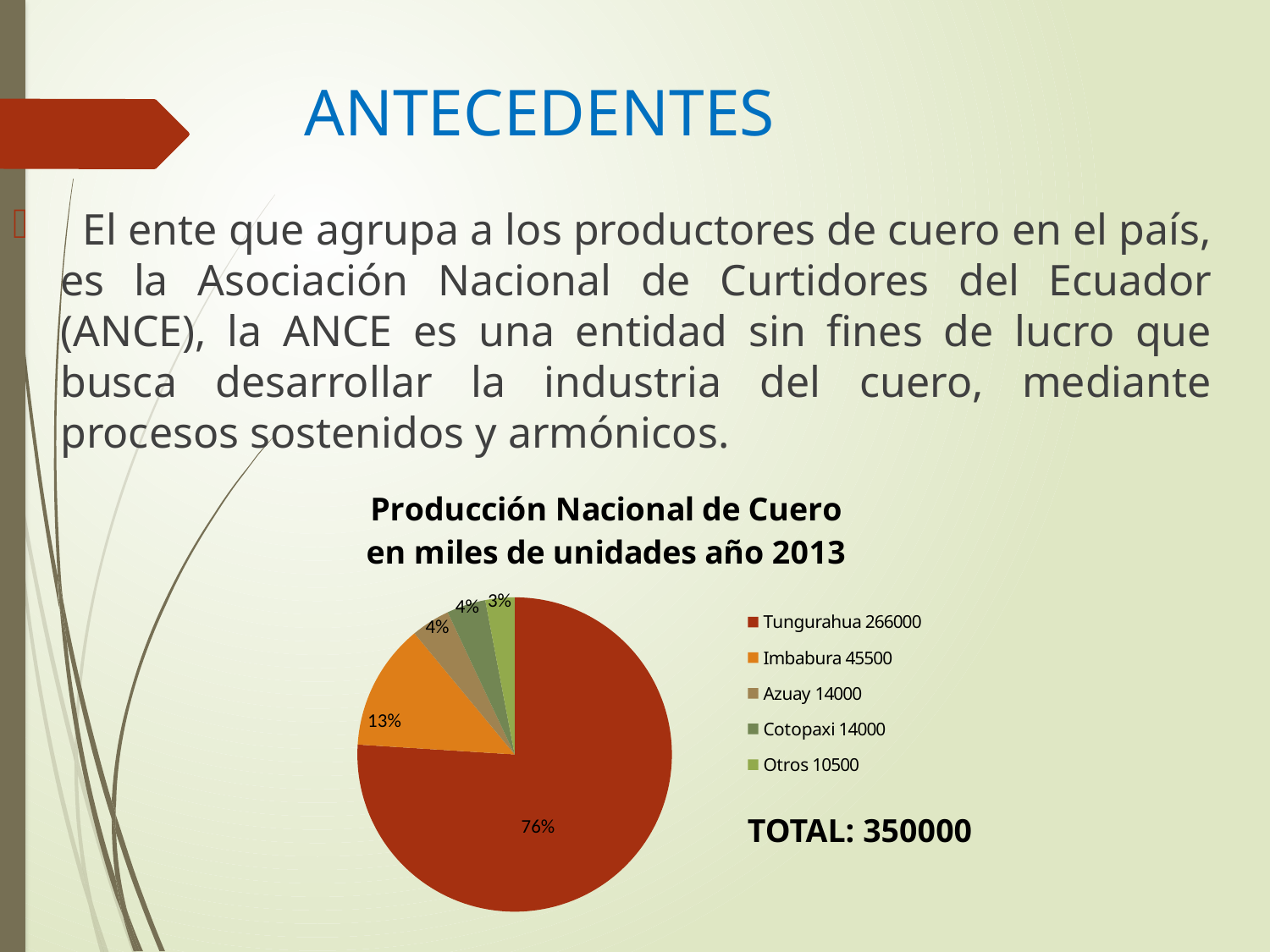
Which is larger, the value for Imbabura or the value for Azuay? Imbabura What kind of chart is shown on the slide? pie chart How many categories does the pie chart have? 5 What is the difference between the values for Tungurahua and Imbabura? 220500 What share of the pie does Tungurahua represent? 76% What share of the pie does Imbabura represent? 13% What is the title of the chart? Producción Nacional de Cuero en miles de unidades año 2013 What value is listed for Cotopaxi in the legend? 14000 What share of the pie does Otros represent? 3% Which category has the largest slice of the pie? Tungurahua What value is listed for Imbabura in the legend? 45500 Which category has the smallest slice of the pie? Otros